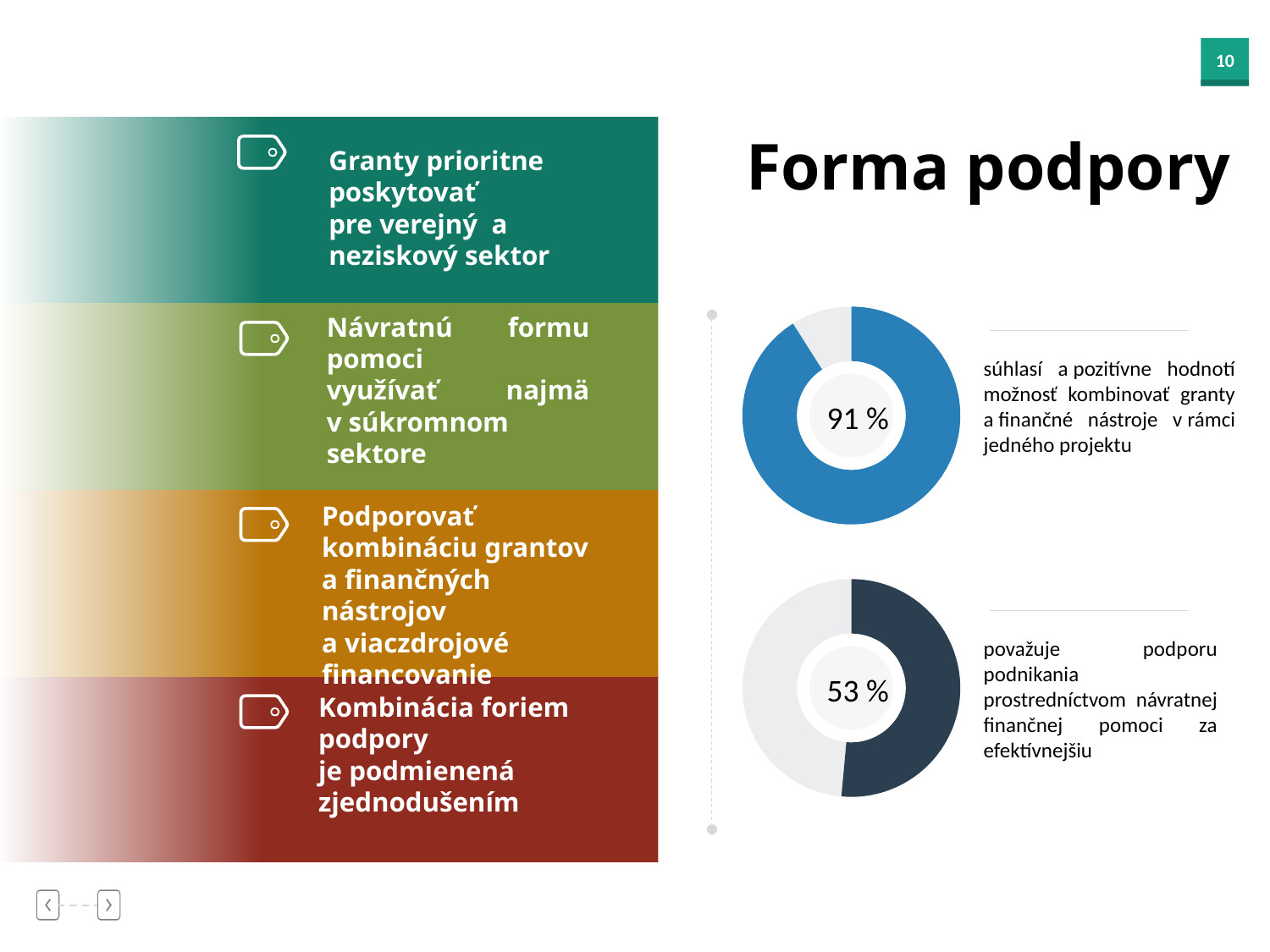
What value is shown in the centre of the bottom donut chart? 53 % What is the difference between the value in the top donut chart (91 %) and the value in the bottom donut chart (53 %)? 38 % What kind of chart is the top chart on the slide? Donut chart What kind of chart is the bottom chart on the slide? Donut chart What value is shown in the centre of the top donut chart? 91 % What colour is the filled segment of the top donut chart? Blue How many segments does the top donut chart have? 2 In the top donut chart, what share of the ring is taken by the coloured (blue) segment? 91 % Which chart shows the larger value, the top donut chart or the bottom donut chart? The top donut chart What is the title of the slide containing the two donut charts? Forma podpory How many donut charts are on the slide? 2